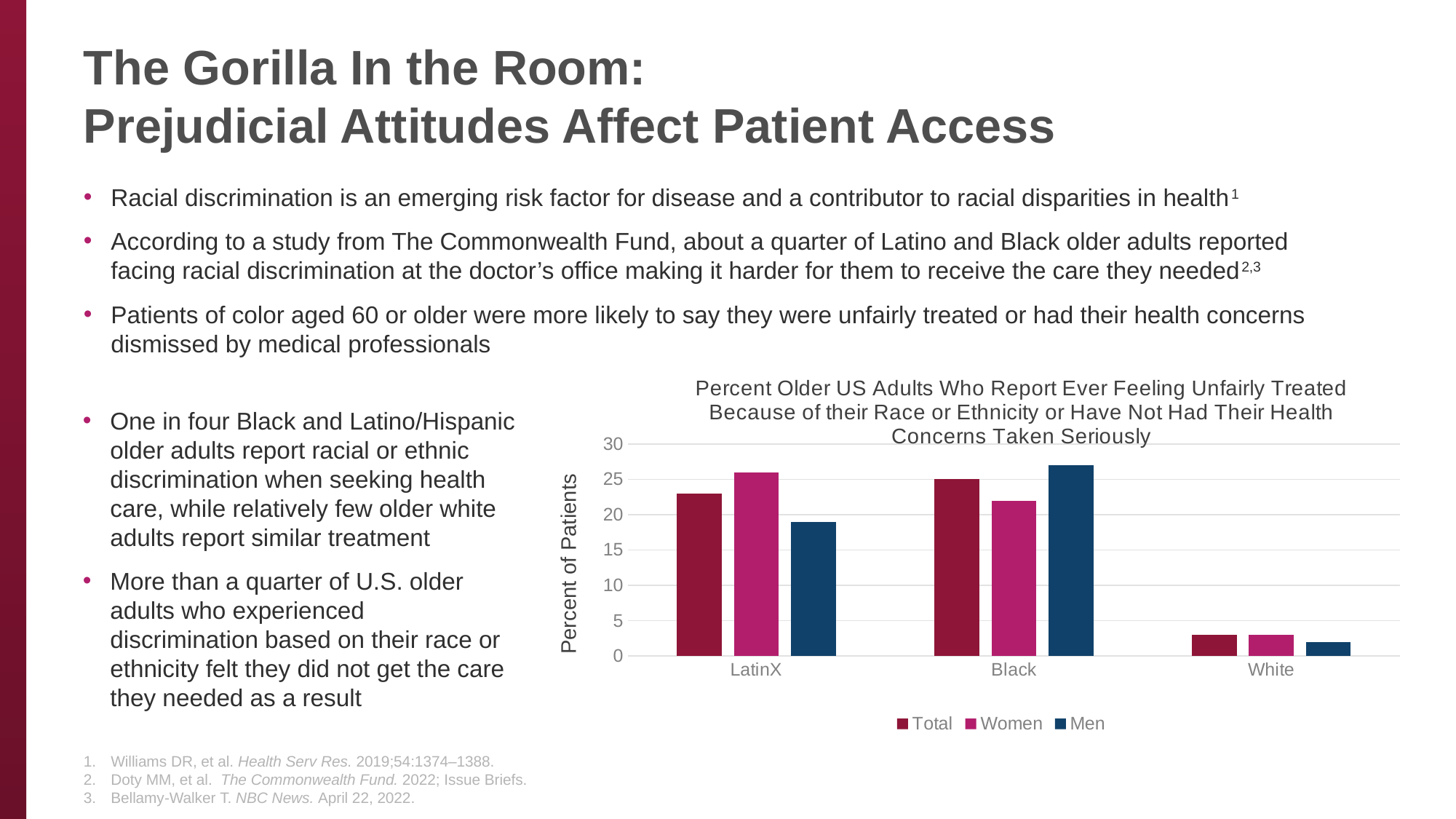
Which series has the highest value in the Black category? Men Is the value for Men in the Black category greater or less than 25? greater Is the value for Total in the White category greater or less than 5? less Is the value for Total in the LatinX category greater or less than 20? greater What kind of chart is shown on the slide? bar chart Which category has the lowest Total value in the chart? White Which is larger: the Men value for Black or the Women value for Black? Men value for Black Which series has the highest value in the LatinX category? Women Which is larger: the Women value for LatinX or the Men value for LatinX? Women value for LatinX What is the label of the vertical axis of the chart? Percent of Patients How many categories are shown on the x axis of the chart? 3 How many series does the chart legend list? 3